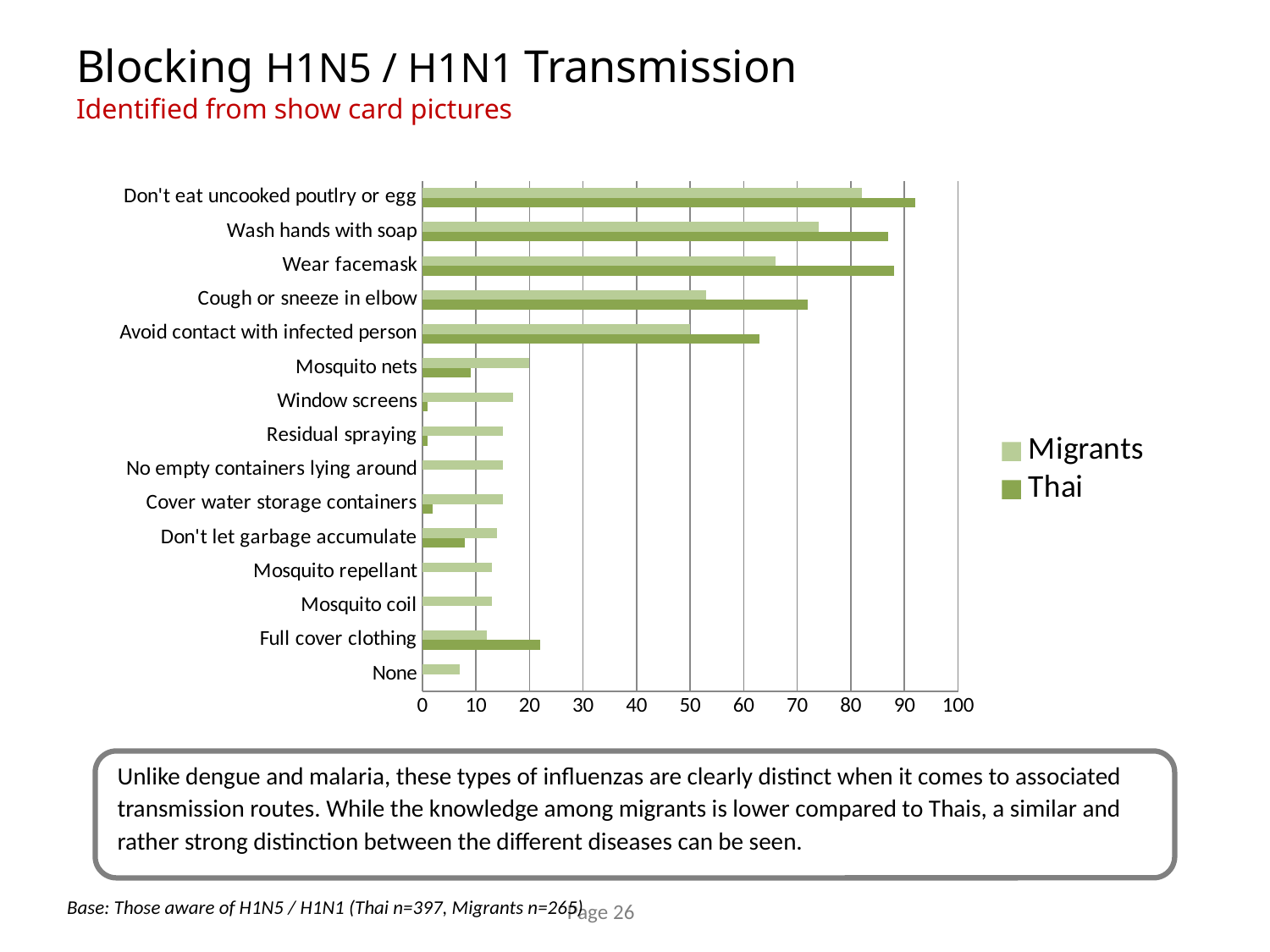
Which category has the highest value for Migrants? Don't eat uncooked poutlry or egg For Wash hands with soap, which series has the larger value, Migrants or Thai? Thai Which category has the lowest value for Migrants? None How many categories are plotted on the chart? 15 What kind of chart is shown on the slide? bar chart For Mosquito nets, which series has the larger value, Migrants or Thai? Migrants Which category has the highest value for Thai? Don't eat uncooked poutlry or egg Is the Thai value for Full cover clothing greater or less than 20? greater Is the Thai value for Wear facemask greater or less than 80? greater Which series is shown in the darker green colour? Thai Is the Migrants value for Cough or sneeze in elbow greater or less than 60? less How many series does the legend list? 2